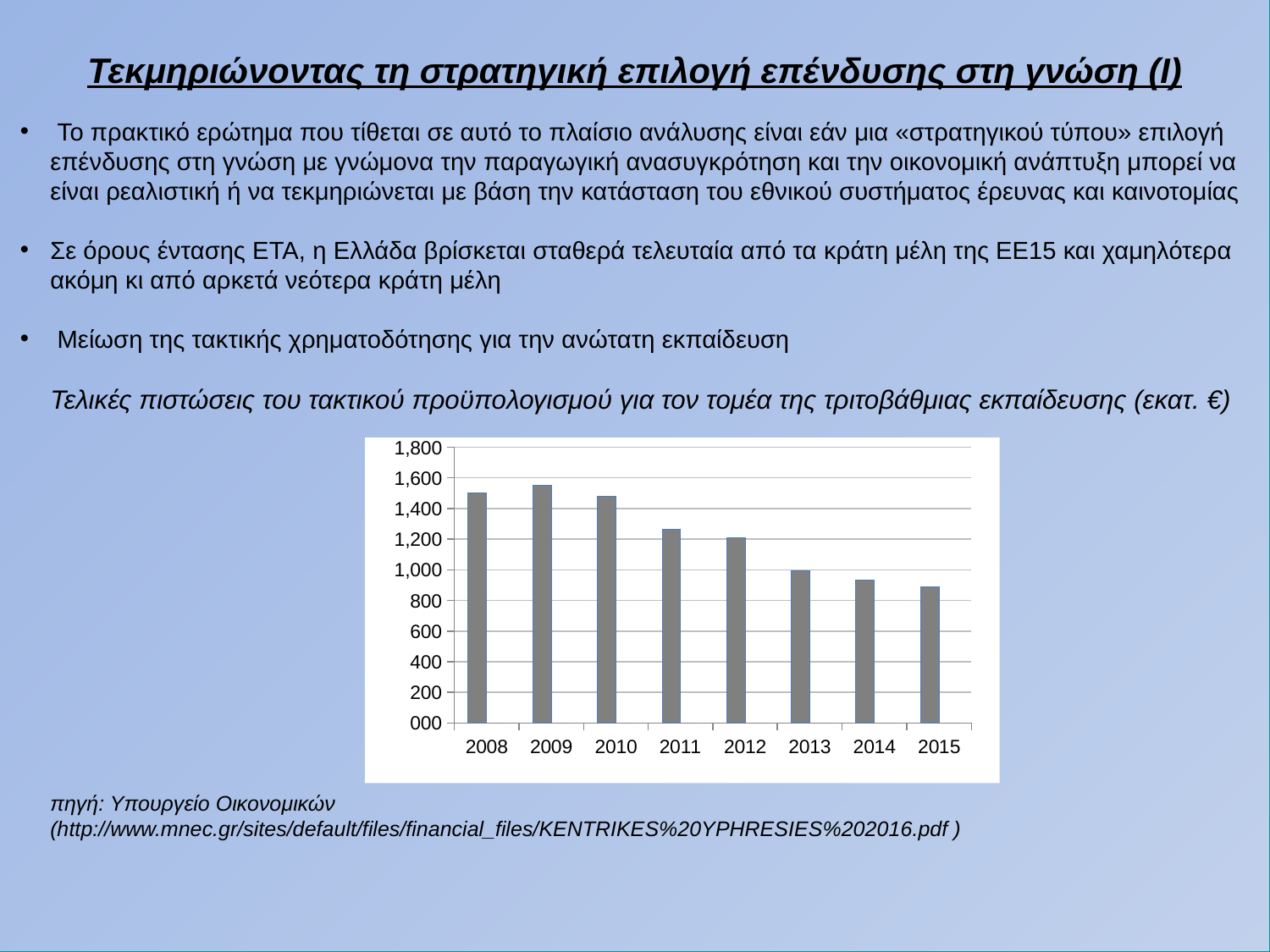
What is the first year shown on the x axis of the chart? 2008 What kind of chart is shown on the slide? bar chart How many years are shown on the x axis of the chart? 8 Is the value for 2015 greater or less than 1,000? less Is the value for 2014 greater or less than 1,000? less Is the value for 2008 greater or less than 1,400? greater Which year has the highest bar in the chart? 2009 Which year has the larger value, 2011 or 2013? 2011 Do the values generally rise or fall from 2008 to 2015? fall Which year has the lowest bar in the chart? 2015